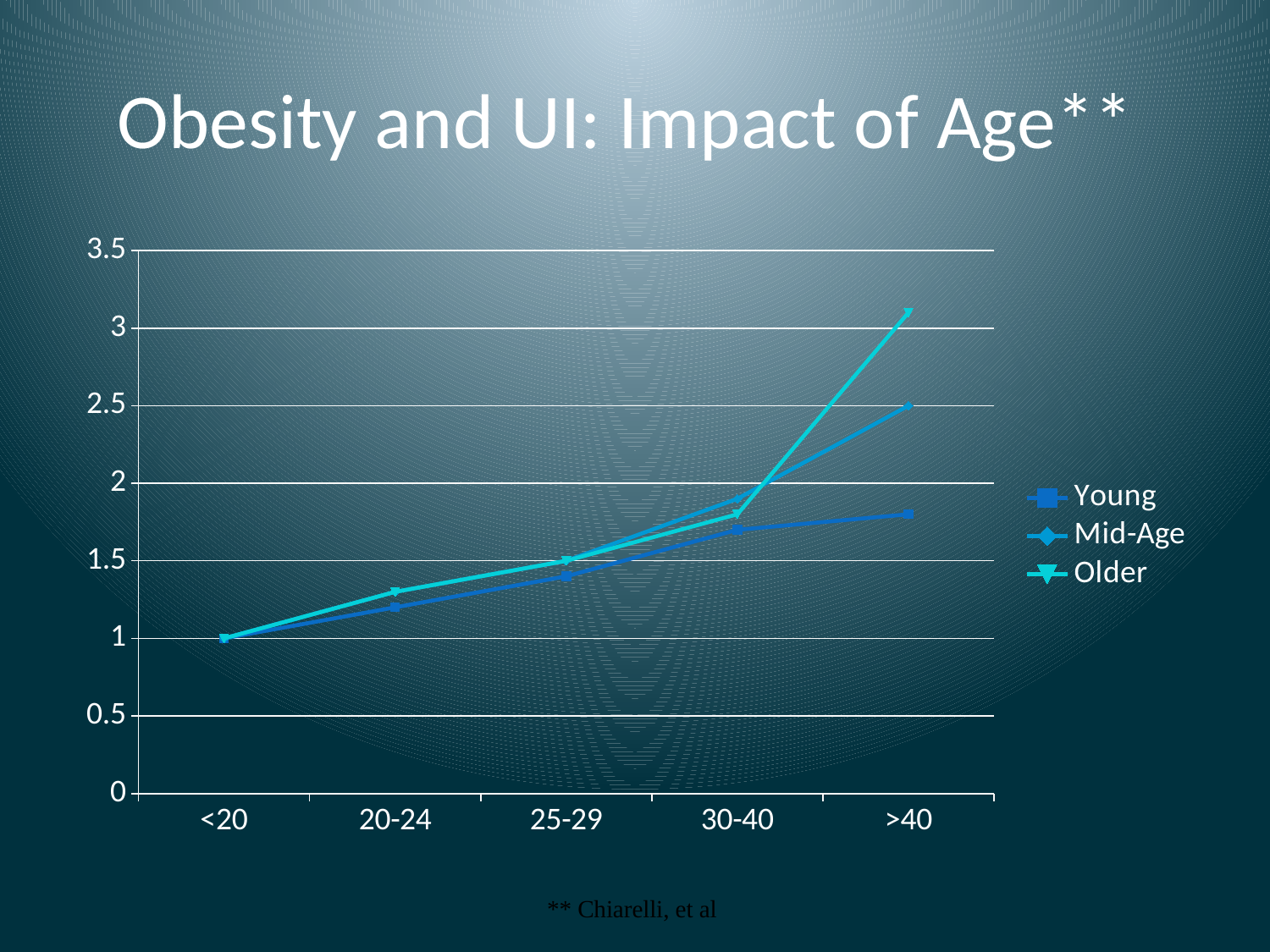
How many series does the legend list? 3 At the 20-24 category, which is larger: the Older series or the Young series? Older What is the value for the Young series at the <20 category? 1 How many age categories are shown on the x axis? 5 Is the value for the Young series at >40 greater or less than 2? less Which series has the highest value at the >40 category? Older What is the title of the slide containing the chart? Obesity and UI: Impact of Age** Which series has the lowest value at the >40 category? Young What kind of chart is shown on the slide? line chart Do the values for the Older series rise or fall from <20 to >40? rise What are the three series named in the legend? Young, Mid-Age, Older Is the value for the Older series at >40 greater or less than 3? greater